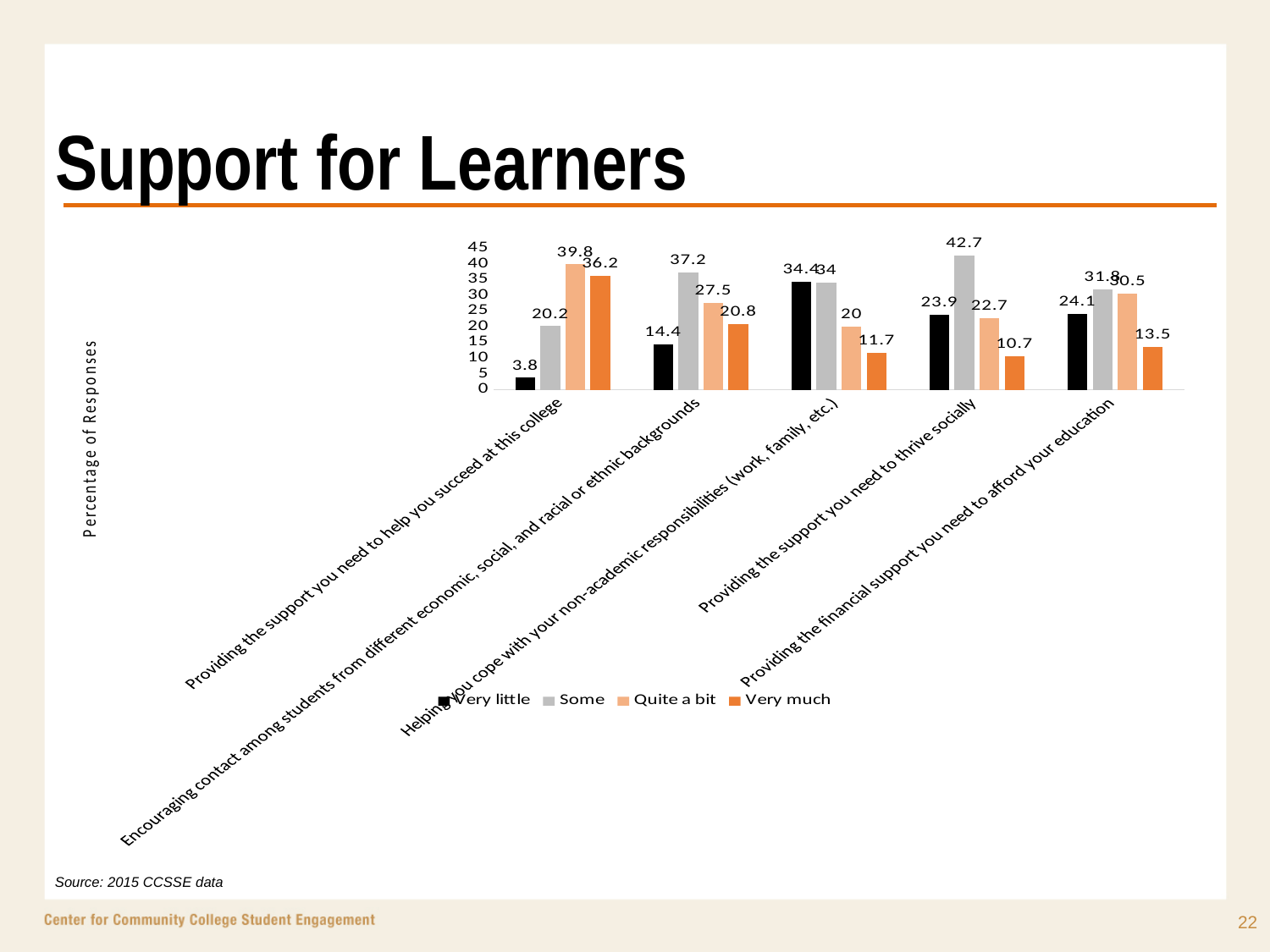
What kind of chart is shown on the slide? Bar chart What is the difference between the "Some" and "Very little" values for "Encouraging contact among students from different economic, social, and racial or ethnic backgrounds"? 22.8 What is the difference between the "Quite a bit" and "Very much" values for "Providing the support you need to help you succeed at this college"? 3.6 What is the value for "Some" for "Providing the support you need to thrive socially"? 42.7 What is the value for "Very little" for "Providing the support you need to help you succeed at this college"? 3.8 What is the value for "Quite a bit" for "Providing the financial support you need to afford your education"? 30.5 Which category has the lowest value for the "Very much" series? Providing the support you need to thrive socially Which category has the highest value for the "Some" series? Providing the support you need to thrive socially What is the value for "Very much" for "Providing the support you need to help you succeed at this college"? 36.2 Which is larger: the "Some" value for "Encouraging contact among students from different economic, social, and racial or ethnic backgrounds" or the "Some" value for "Providing the financial support you need to afford your education"? Encouraging contact among students from different economic, social, and racial or ethnic backgrounds How many categories are shown on the x axis of the chart? 5 How many series does the legend list? 4